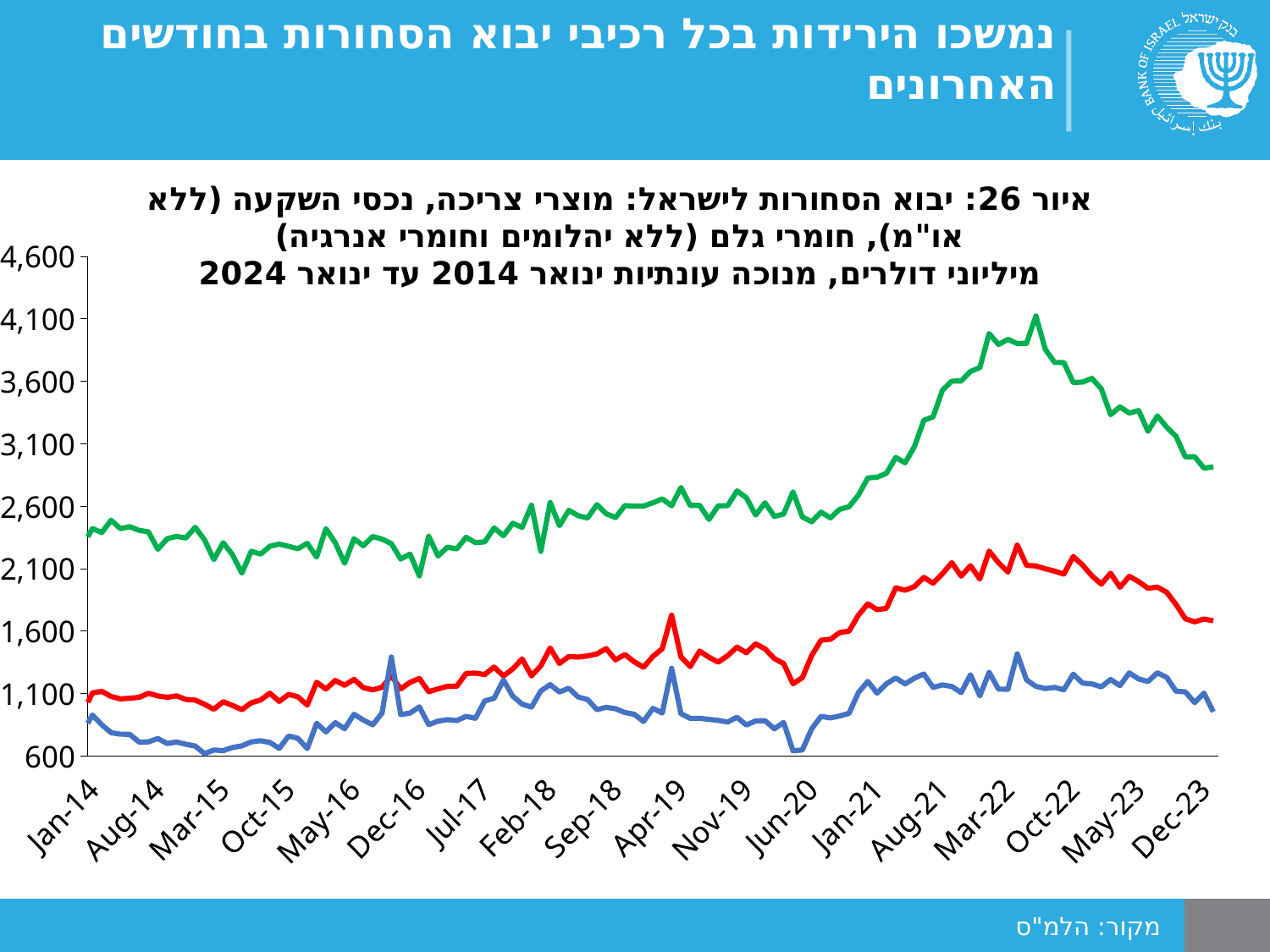
Is the value of the red line at Dec-23 greater or less than 1,600? greater Is the value of the green line at its peak around Mar-22 greater or less than 3,600? greater How many lines are plotted on the chart? 3 What kind of chart is shown on the slide? line chart Does the green line rise or fall between Jan-21 and Mar-22? rise Is the value of the green line at Jan-14 greater or less than 2,100? greater Which line is highest throughout the chart: the green, red or blue line? green What is the first x-axis label on the chart? Jan-14 Does the green line rise or fall between Mar-22 and Dec-23? fall What is the highest value shown on the y-axis? 4,600